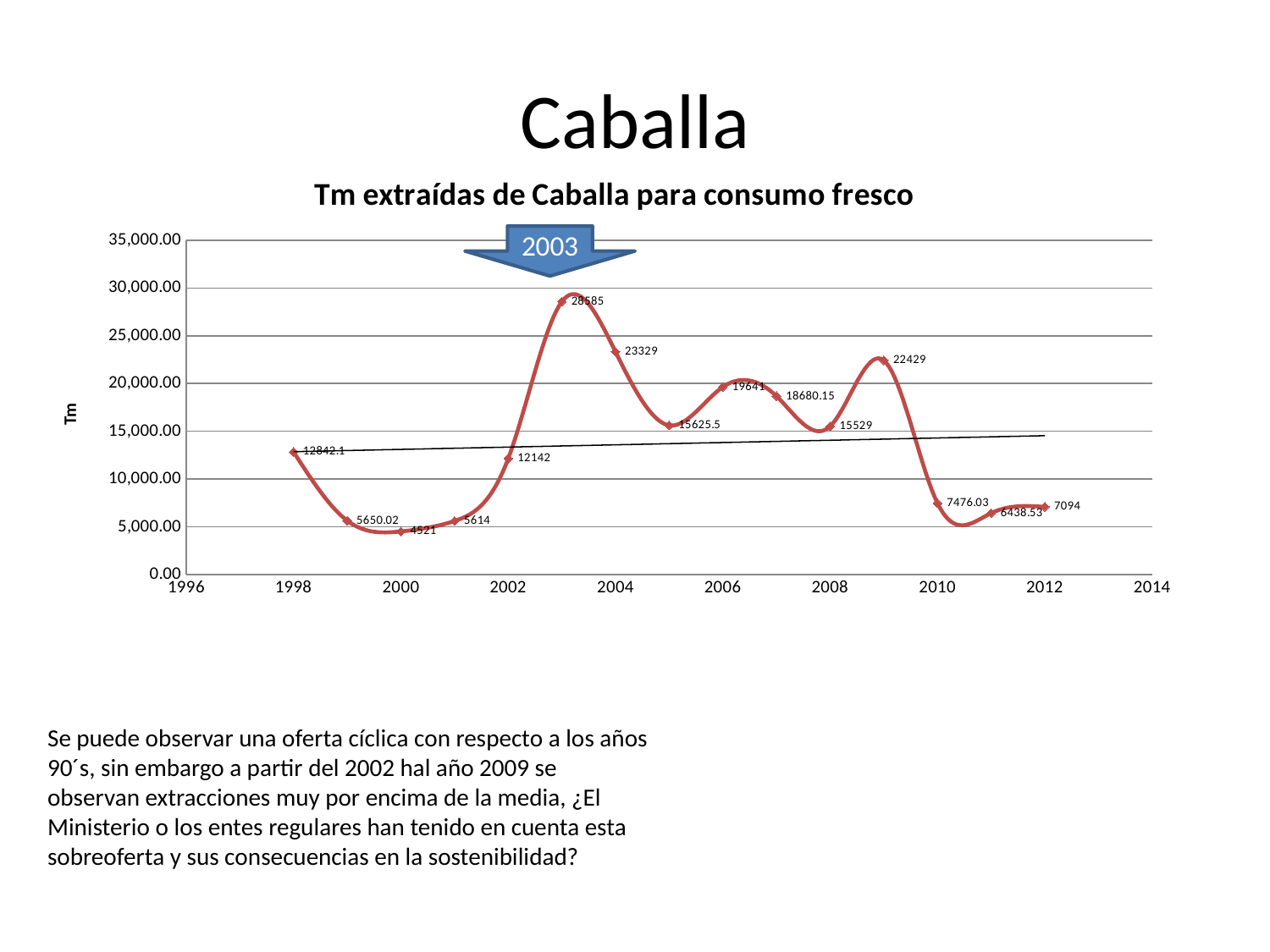
How many data points are plotted on the line? 15 Which is larger, the value for 2006 or the value for 2007? 2006 Do the values rise or fall from 2009 to 2010? fall What is the value for 2003? 28585 What is the title of the chart? Tm extraídas de Caballa para consumo fresco What is the value for 2010? 7476.03 What is the difference between the values for 2003 and 2004? 5256 What kind of chart is shown on the slide? line chart What is the difference between the values for 2009 and 2008? 6900 Which year has the highest value? 2003 What is the value for 1998? 12842.1 Which year has the lowest value? 2000